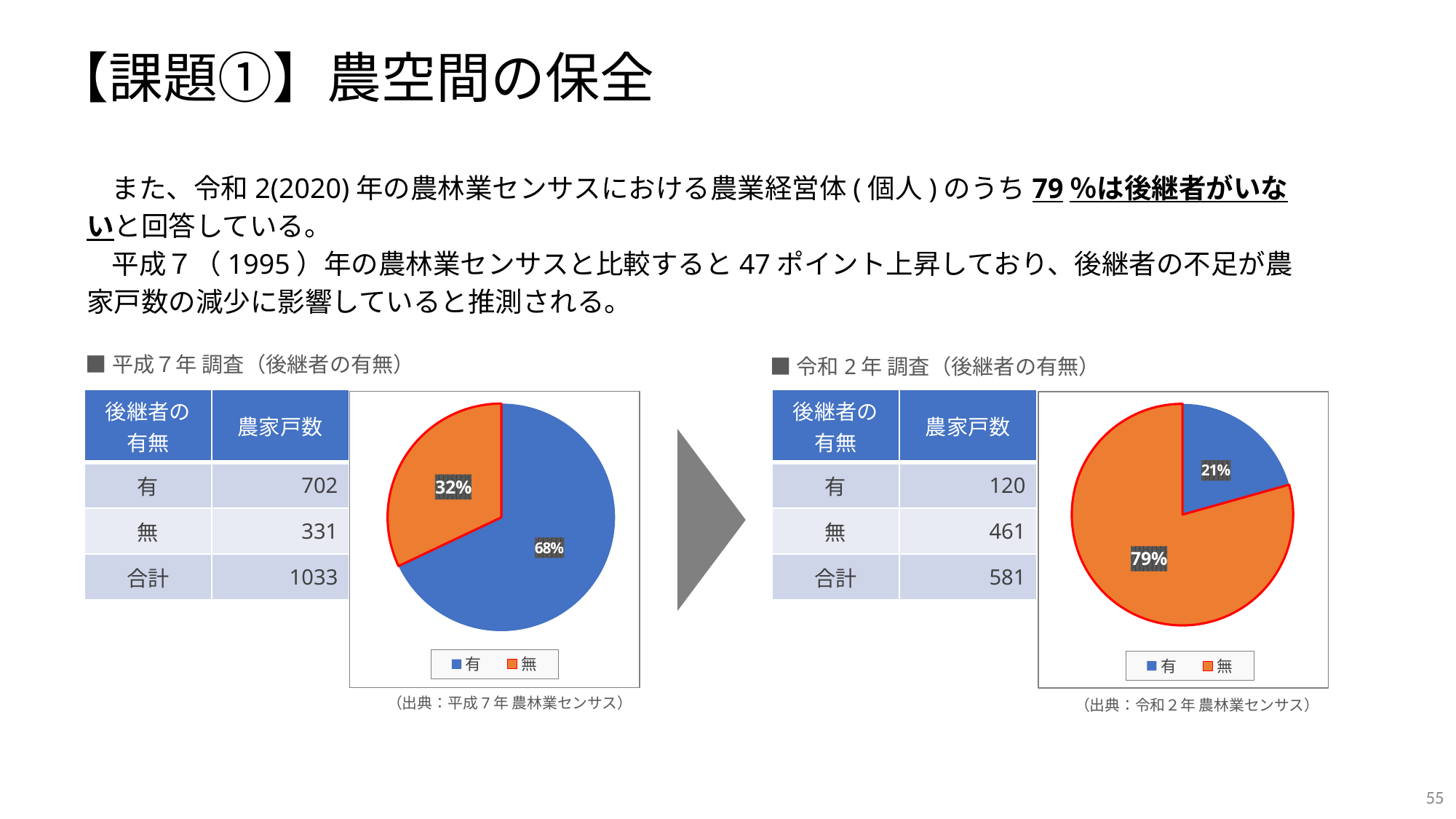
In the right pie chart (令和2年調査), what share of the pie is labelled 有? 21% In the right pie chart (令和2年調査), what is the difference in percentage points between the 無 slice and the 有 slice? 58 How many entries does the legend of the left pie chart (平成7年調査) list? 2 In the right pie chart (令和2年調査), which slice is the smallest? 有 In the left pie chart (平成7年調査), is the 有 slice larger or smaller than the 無 slice? larger In the right pie chart (令和2年調査), what share of the pie is labelled 無? 79% In the left pie chart (平成7年調査), which slice is the largest? 有 What kind of chart is shown on the left (平成7年調査)? pie chart In the right pie chart (令和2年調査), which colour represents 無? orange In the left pie chart (平成7年調査), what share of the pie is labelled 無? 32% How many slices does the right pie chart (令和2年調査) have? 2